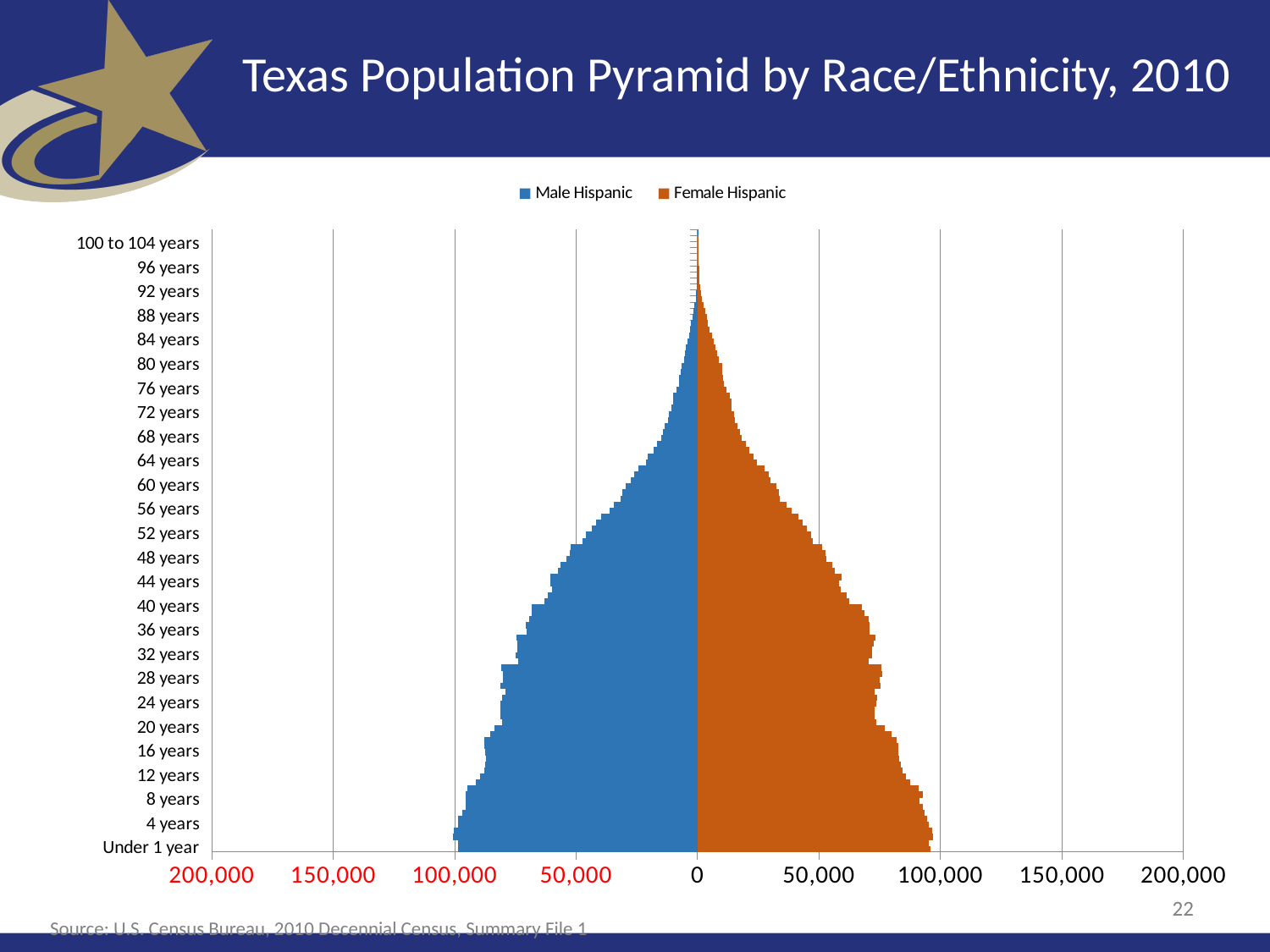
Which is larger for Female Hispanic: the value for 28 years or the value for 72 years? 28 years Which series is shown in orange? Female Hispanic As age increases from Under 1 year to 100 to 104 years, do the Female Hispanic bars generally get longer or shorter? shorter Is the Female Hispanic value for 20 years greater or less than 50,000? greater What is the title of the chart? Texas Population Pyramid by Race/Ethnicity, 2010 Which is larger for Male Hispanic: the value for 4 years or the value for 60 years? 4 years Is the Male Hispanic value for 40 years greater or less than 50,000? greater Is the Female Hispanic value for 60 years greater or less than 50,000? less What kind of chart is shown on the slide? bar chart How many series does the legend list? 2